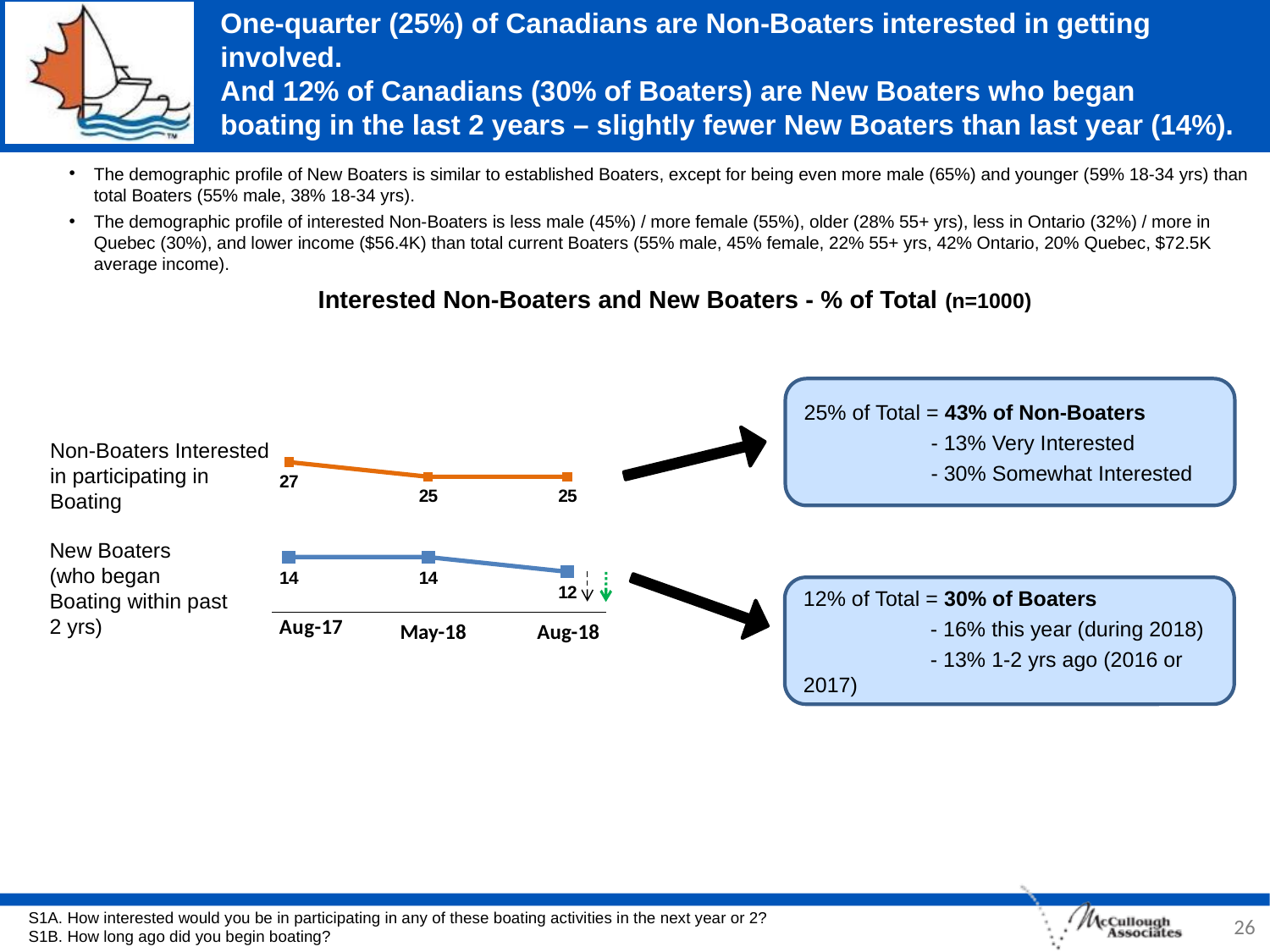
What is the difference between Non-Boaters Interested and New Boaters in Aug-18? 13 What is the value for New Boaters in Aug-18? 12 How many time periods are plotted on the x axis? 3 What is the value for New Boaters in May-18? 14 In which period was the New Boaters series lowest? Aug-18 Does the New Boaters series rise or fall from Aug-17 to Aug-18? Fall What type of chart is shown on the slide? Line chart In which period was the Non-Boaters Interested series highest? Aug-17 What is the value for Non-Boaters Interested in participating in Boating in May-18? 25 By how much did the New Boaters value fall from May-18 to Aug-18? 2 Which is larger in Aug-17: Non-Boaters Interested or New Boaters? Non-Boaters Interested What is the value for Non-Boaters Interested in participating in Boating in Aug-17? 27